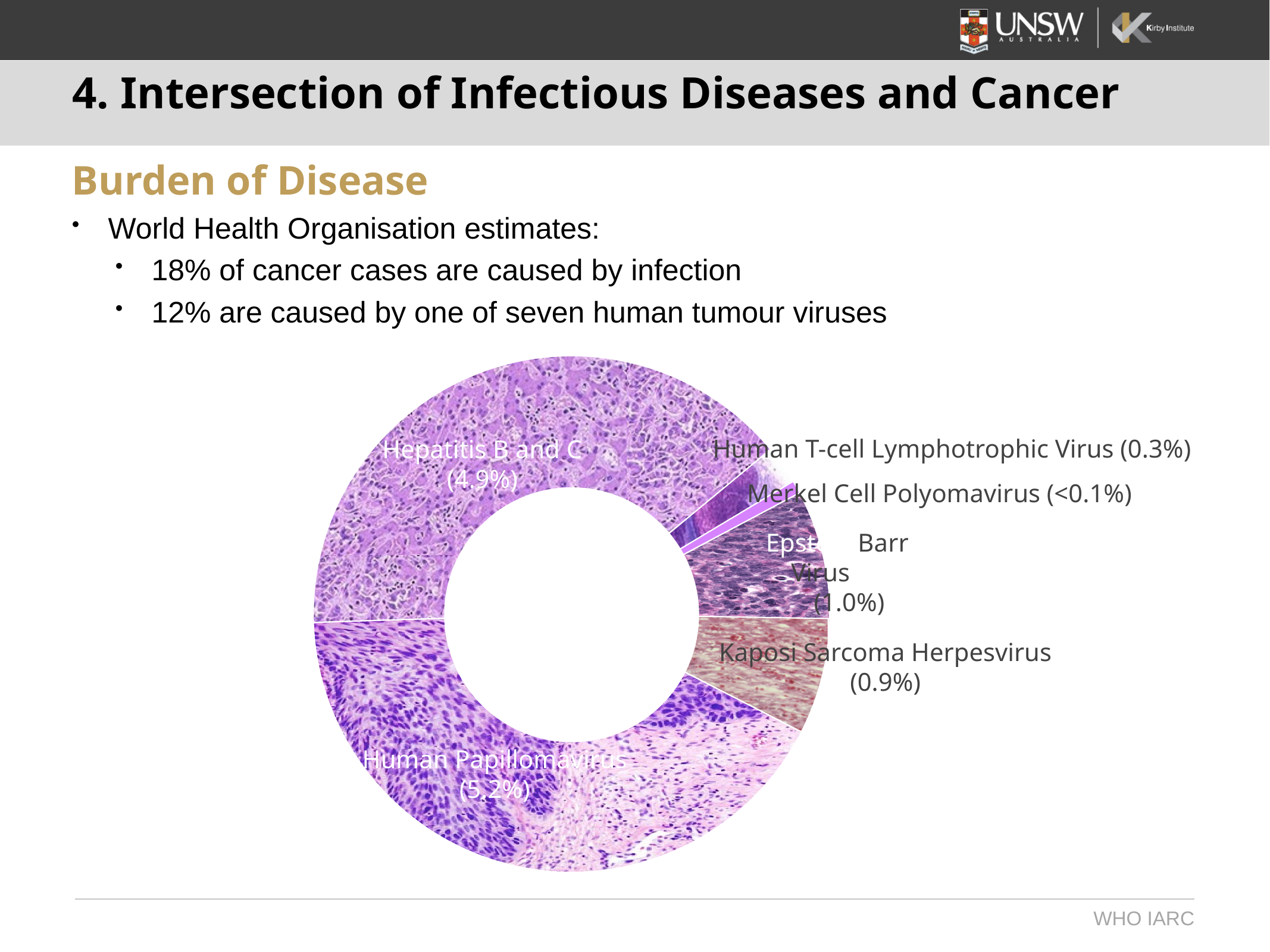
What percentage is shown for Hepatitis B and C in the chart? 4.9% What percentage is shown for Kaposi Sarcoma Herpesvirus in the chart? 0.9% Which virus has the largest slice in the chart? Human Papillomavirus What percentage is shown for Epstein Barr Virus in the chart? 1.0% What percentage is shown for Human Papillomavirus in the chart? 5.2% What type of chart is shown on the slide? doughnut chart What percentage is shown for Merkel Cell Polyomavirus in the chart? <0.1% What percentage is shown for Human T-cell Lymphotrophic Virus in the chart? 0.3% Which virus has the smallest slice in the chart? Merkel Cell Polyomavirus Which has a larger percentage, Epstein Barr Virus or Kaposi Sarcoma Herpesvirus? Epstein Barr Virus How many virus categories are shown in the chart? 6 What is the difference in percentage points between Human Papillomavirus and Hepatitis B and C? 0.3